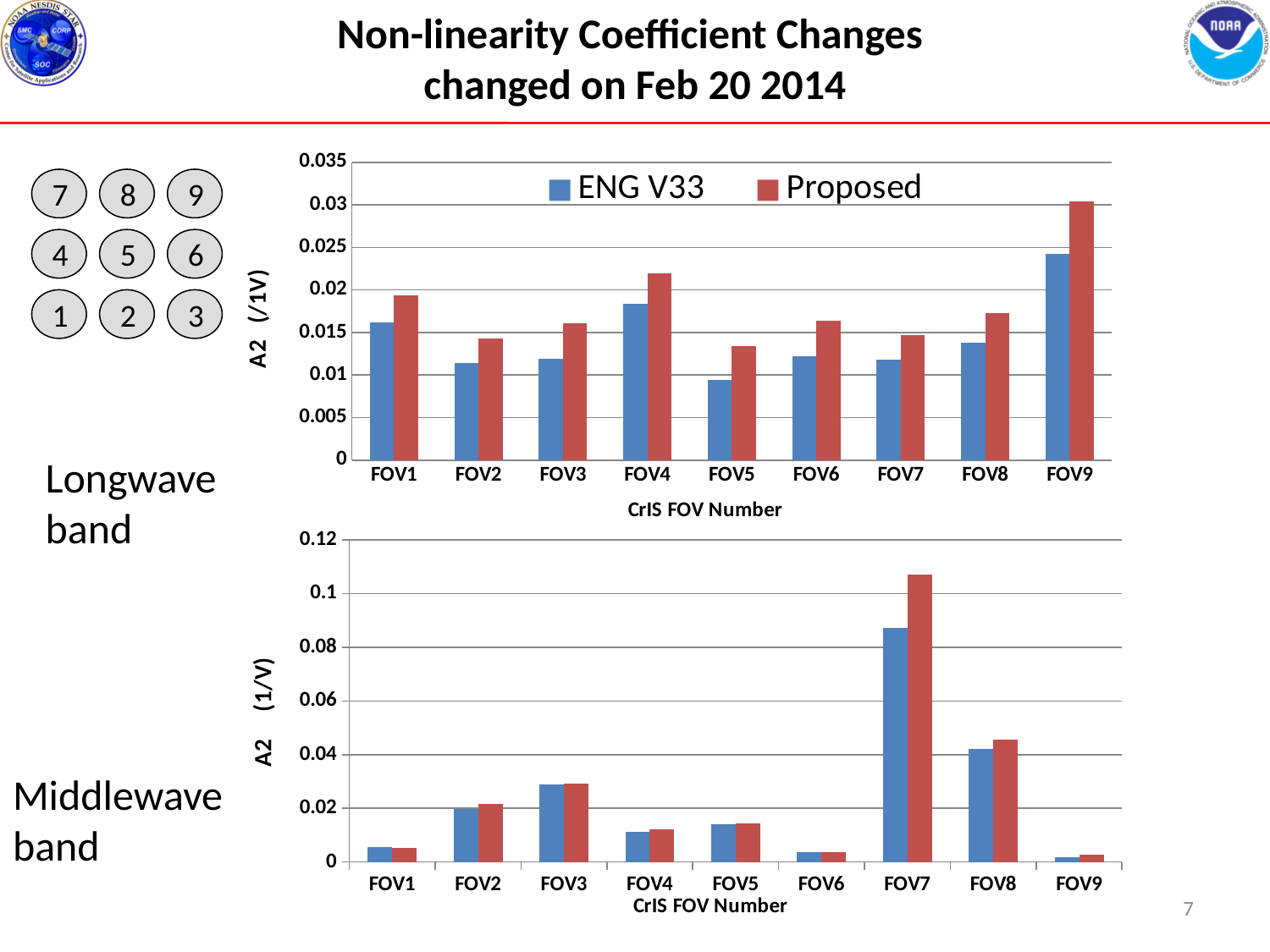
What is the x-axis title of the Middlewave band chart? CrIS FOV Number In the Longwave band chart, is the ENG V33 value for FOV9 greater or less than 0.02? greater How many FOV categories are shown on the x axis of the Middlewave band chart? 9 In the Middlewave band chart, which FOV has the lowest ENG V33 value? FOV9 In the Middlewave band chart, which FOV has the highest Proposed value? FOV7 In the Longwave band chart, which FOV has the lowest ENG V33 value? FOV5 In the Longwave band chart, which is larger for FOV1, the ENG V33 value or the Proposed value? Proposed In the Longwave band chart, is the ENG V33 value for FOV5 greater or less than 0.01? less In the Middlewave band chart, is the Proposed value for FOV7 greater or less than 0.1? greater In the Longwave band chart, which FOV has the highest Proposed value? FOV9 What type of chart is the Longwave band chart at the top of the slide? bar chart How many series does the legend of the Longwave band chart list? 2